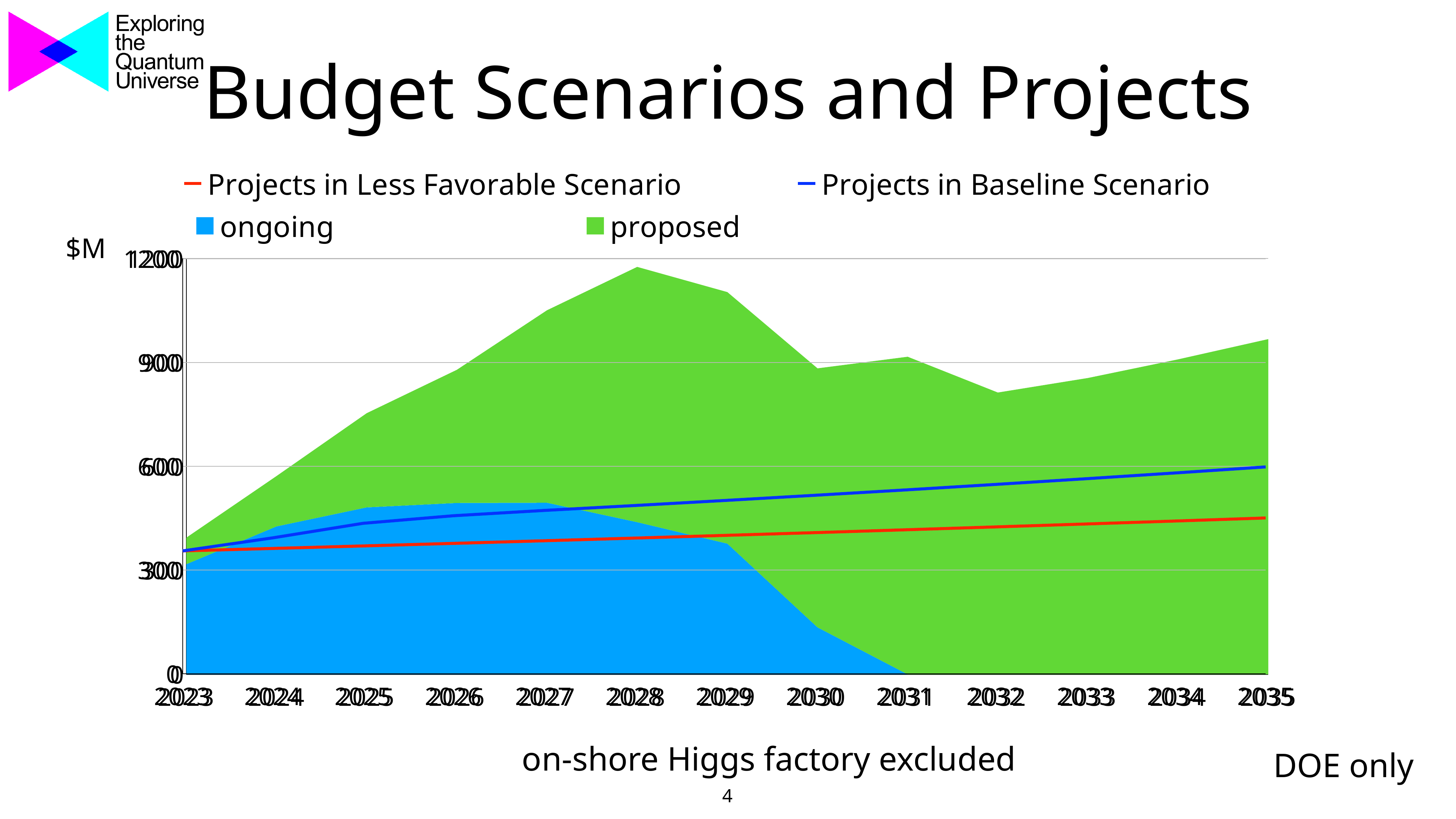
Is the total of ongoing plus proposed projects in 2032 greater or less than 900? less Is the value for ongoing projects in 2027 greater or less than 600? less How many series does the legend list? 4 What unit is shown on the y axis of the chart? $M Which year has the highest total of ongoing plus proposed projects? 2028 Is the value for Projects in Less Favorable Scenario in 2035 greater or less than 600? less How many years are shown along the x axis? 13 Does the Projects in Baseline Scenario line rise or fall from 2023 to 2035? rise In 2035, which is larger: Projects in Baseline Scenario or Projects in Less Favorable Scenario? Projects in Baseline Scenario What kind of chart is shown on the slide? area chart